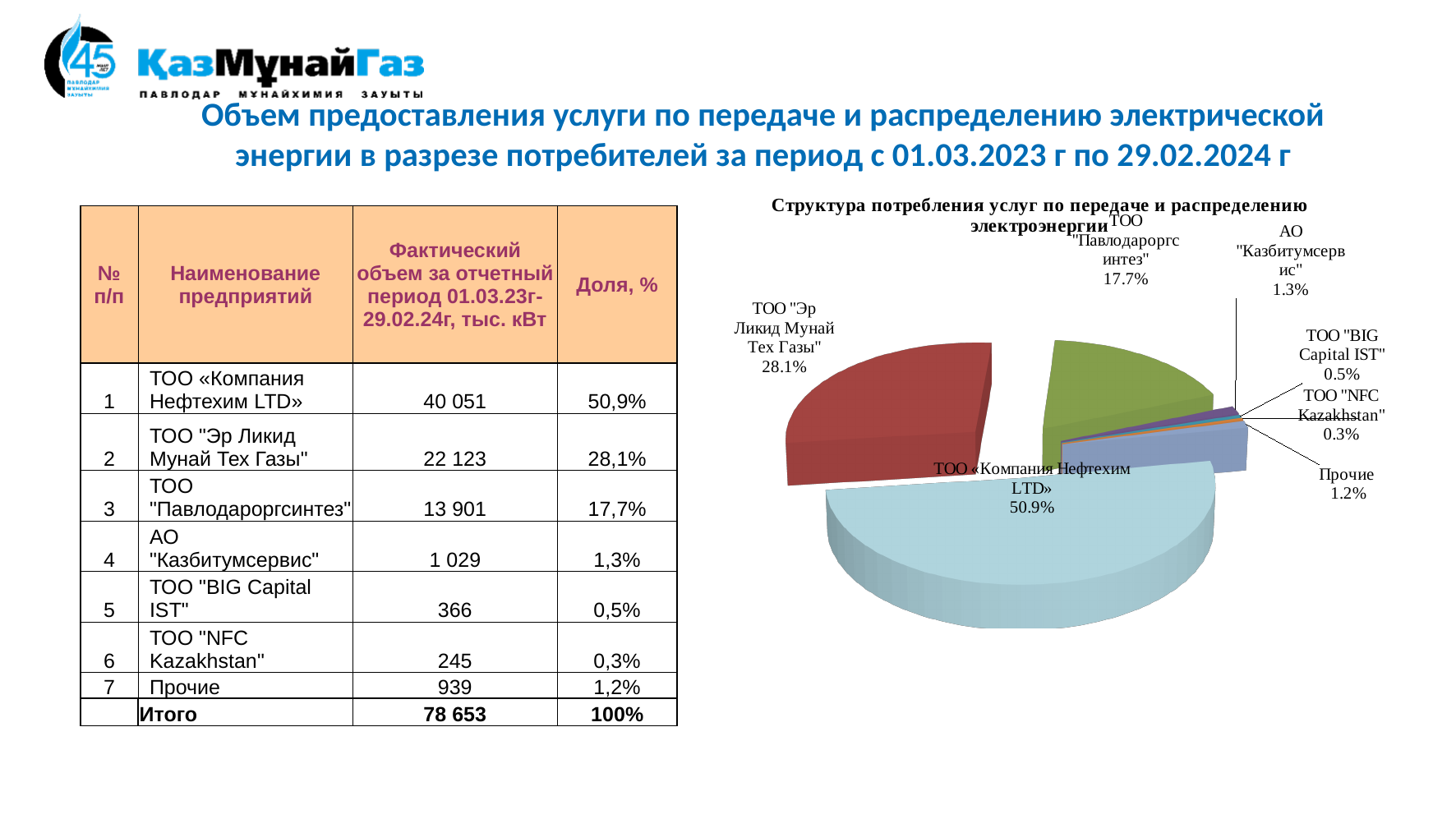
Which slice of the pie chart is the largest? ТОО «Компания Нефтехим LTD» What share of the pie chart does ТОО "Павлодароргсинтез" hold? 17.7% What share of the pie chart does ТОО "NFC Kazakhstan" hold? 0.3% What share of the pie chart does ТОО "Эр Ликид Мунай Тех Газы" hold? 28.1% What is the difference in percentage points between the shares of ТОО "Эр Ликид Мунай Тех Газы" and ТОО "Павлодароргсинтез" in the pie chart? 10.4% What is the title of the pie chart? Структура потребления услуг по передаче и распределению электроэнергии Which slice of the pie chart is the smallest? ТОО "NFC Kazakhstan" Which has a larger share in the pie chart, ТОО "BIG Capital IST" or Прочие? Прочие How many slices does the pie chart have? 7 What kind of chart is shown on the slide? pie chart